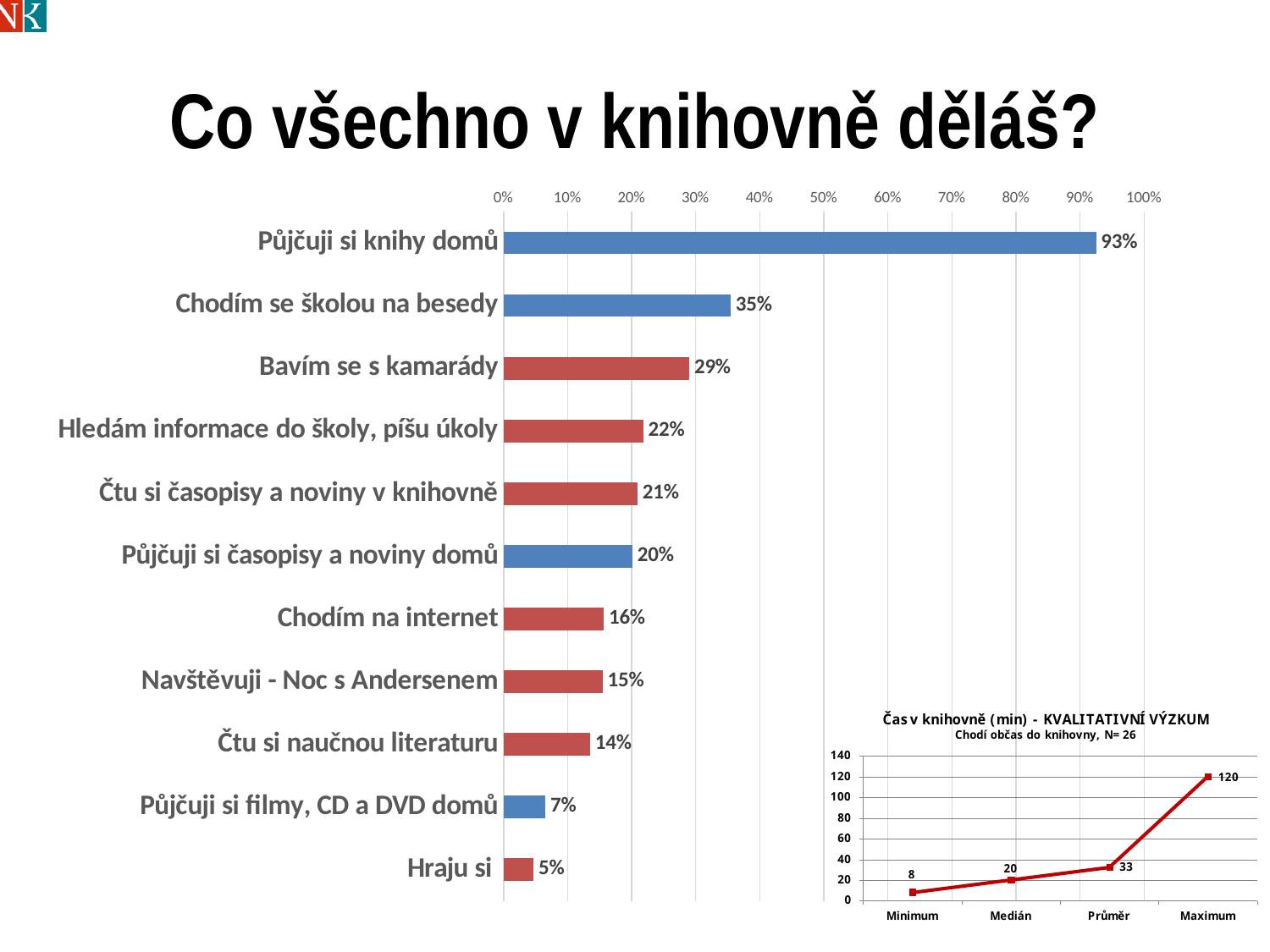
In the chart titled "Čas v knihovně (min) - KVALITATIVNÍ VÝZKUM", do the values rise or fall from Minimum to Maximum? rise In the chart titled "Čas v knihovně (min) - KVALITATIVNÍ VÝZKUM", what is the value for Maximum? 120 In the large bar chart, which category has the lowest value? Hraju si How many categories does the large bar chart show? 11 In the large bar chart, which category has the highest value? Půjčuji si knihy domů In the large bar chart, what is the value for "Chodím na internet"? 16% In the chart titled "Čas v knihovně (min) - KVALITATIVNÍ VÝZKUM", what is the difference between Průměr and Minimum? 25 What kind of chart is the large chart on the slide? bar chart In the large bar chart, what is the value for "Půjčuji si knihy domů"? 93% In the large bar chart, which is larger: "Čtu si naučnou literaturu" or "Půjčuji si časopisy a noviny domů"? Půjčuji si časopisy a noviny domů In the large bar chart, what is the difference between "Chodím se školou na besedy" and "Bavím se s kamarády"? 6% In the chart titled "Čas v knihovně (min) - KVALITATIVNÍ VÝZKUM", what is the value for Medián? 20